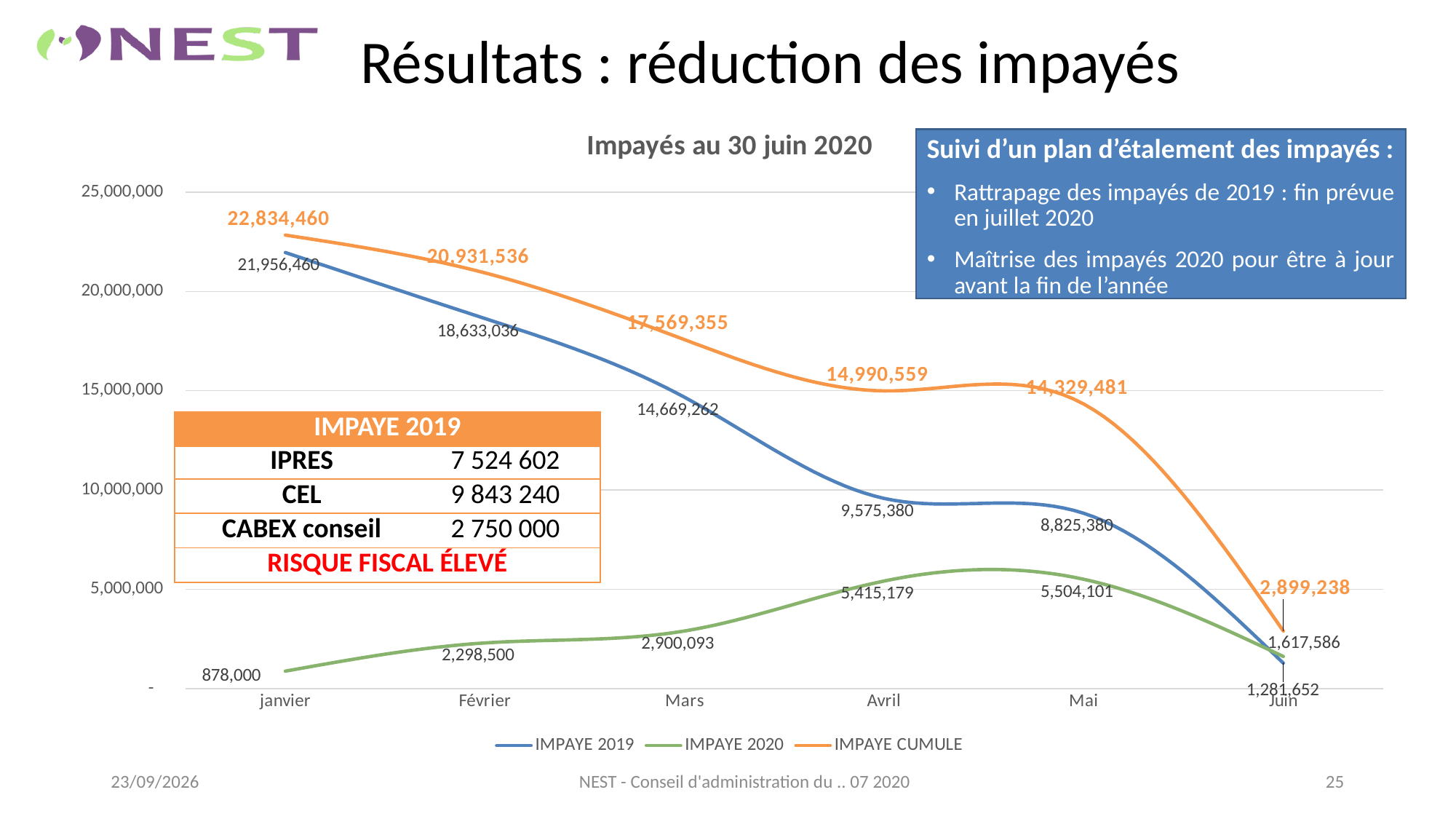
How many months are plotted along the x axis of the chart? 6 Does IMPAYE 2019 rise or fall from janvier to Juin? fall What is the value of IMPAYE 2019 in janvier? 21,956,460 What is the title of the chart? Impayés au 30 juin 2020 How many series does the chart legend list? 3 In which month is IMPAYE 2020 at its highest? Mai Which is larger in Juin, IMPAYE 2019 or IMPAYE 2020? IMPAYE 2020 In which month is IMPAYE CUMULE at its lowest? Juin What type of chart is shown on the slide? line chart What is the value of IMPAYE CUMULE in Mars? 17,569,355 What is the value of IMPAYE 2020 in Avril? 5,415,179 What is the difference between IMPAYE 2019 in janvier and in Juin? 20,674,808